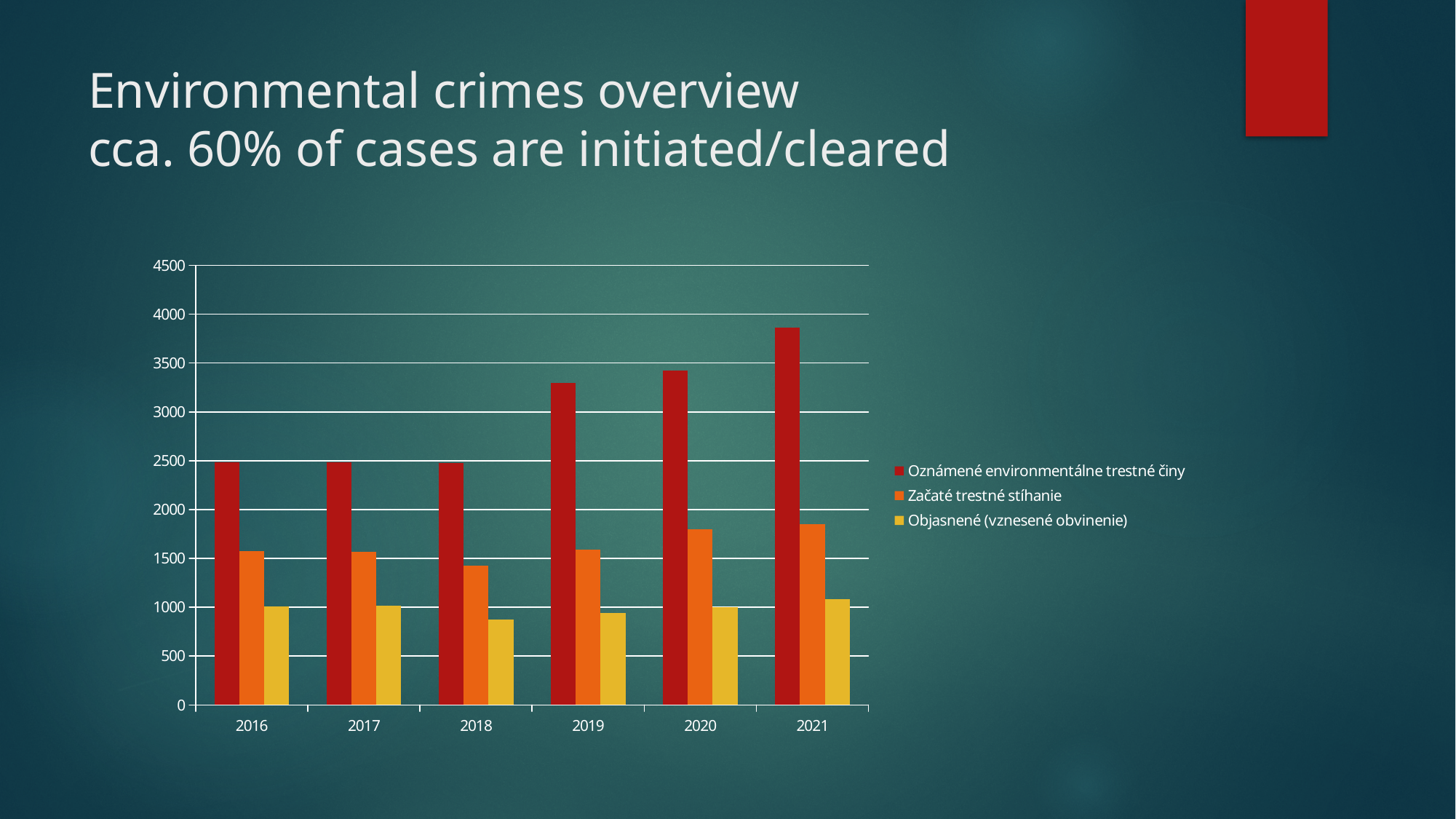
Which is larger: Oznámené environmentálne trestné činy in 2021 or in 2016? 2021 Is the value for Začaté trestné stíhanie in 2018 greater or less than 1500? less Do the values for Oznámené environmentálne trestné činy rise or fall from 2016 to 2021? rise In which year is the value for Začaté trestné stíhanie lowest? 2018 What kind of chart is shown on the slide? bar chart Is the value for Oznámené environmentálne trestné činy in 2016 greater or less than 3000? less How many series does the legend list? 3 Which colour represents Objasnené (vznesené obvinenie) in the chart? yellow In which year is the value for Oznámené environmentálne trestné činy highest? 2021 In which year is the value for Objasnené (vznesené obvinenie) lowest? 2018 How many years are shown on the x axis? 6 Is the value for Oznámené environmentálne trestné činy in 2021 greater or less than 3500? greater